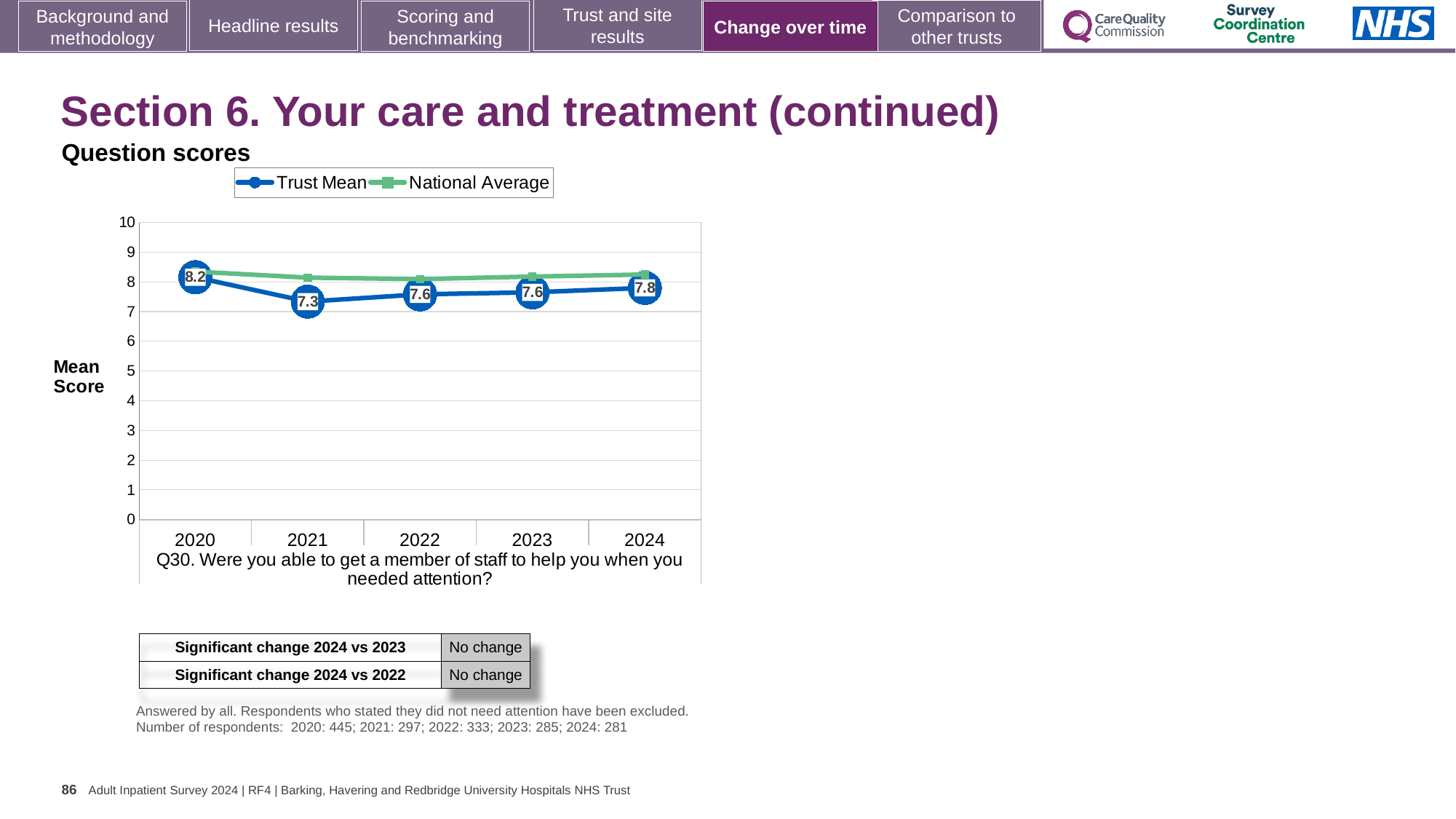
Which is larger, the Trust Mean score for 2024 or for 2021? 2024 In which year is the Trust Mean score highest? 2020 Does the Trust Mean score rise or fall from 2021 to 2024? Rise What kind of chart is shown? Line chart How many series does the legend list? 2 What is the Trust Mean score for 2020? 8.2 What is the Trust Mean score for 2024? 7.8 In which year is the Trust Mean score lowest? 2021 How many years are plotted on the x axis? 5 What is the Trust Mean score for 2021? 7.3 Is the National Average value for 2020 greater or less than 7? greater What is the difference between the Trust Mean scores for 2020 and 2021? 0.9